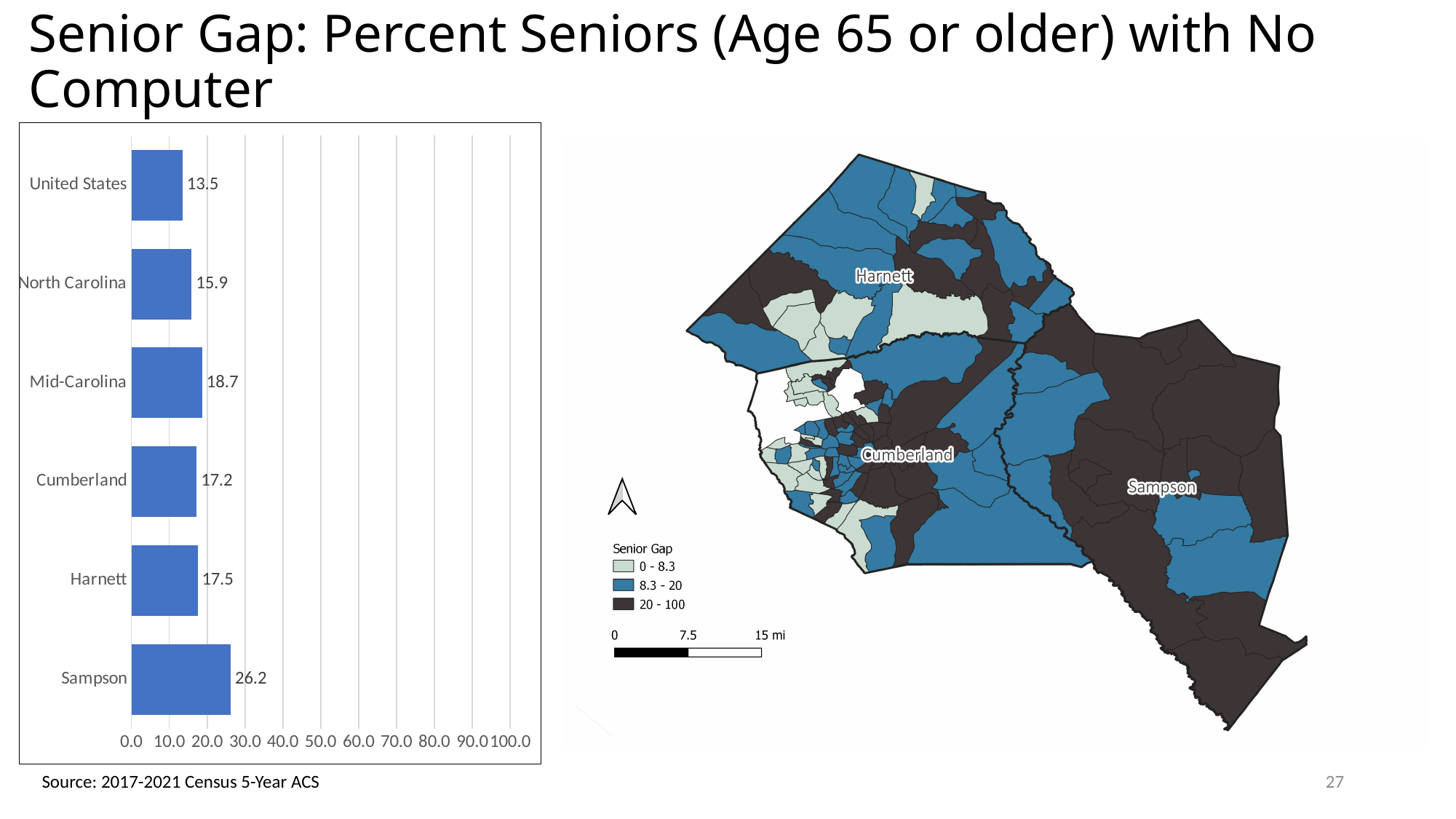
What kind of chart is shown on the left of the slide? bar chart In the bar chart on the left, which category has the lowest value? United States In the bar chart on the left, what is the difference between the values for Sampson and Cumberland? 9.0 In the map on the right, how many classes does the Senior Gap legend list? 3 In the bar chart on the left, which category has the highest value? Sampson In the bar chart on the left, what is the value for Sampson? 26.2 In the bar chart on the left, what is the value for Mid-Carolina? 18.7 How many categories are shown in the bar chart on the left? 6 In the bar chart on the left, is the value for Sampson greater or less than 20.0? greater In the bar chart on the left, what is the difference between the values for North Carolina and United States? 2.4 In the bar chart on the left, what is the value for United States? 13.5 In the bar chart on the left, which is larger, the value for Mid-Carolina or the value for Harnett? Mid-Carolina